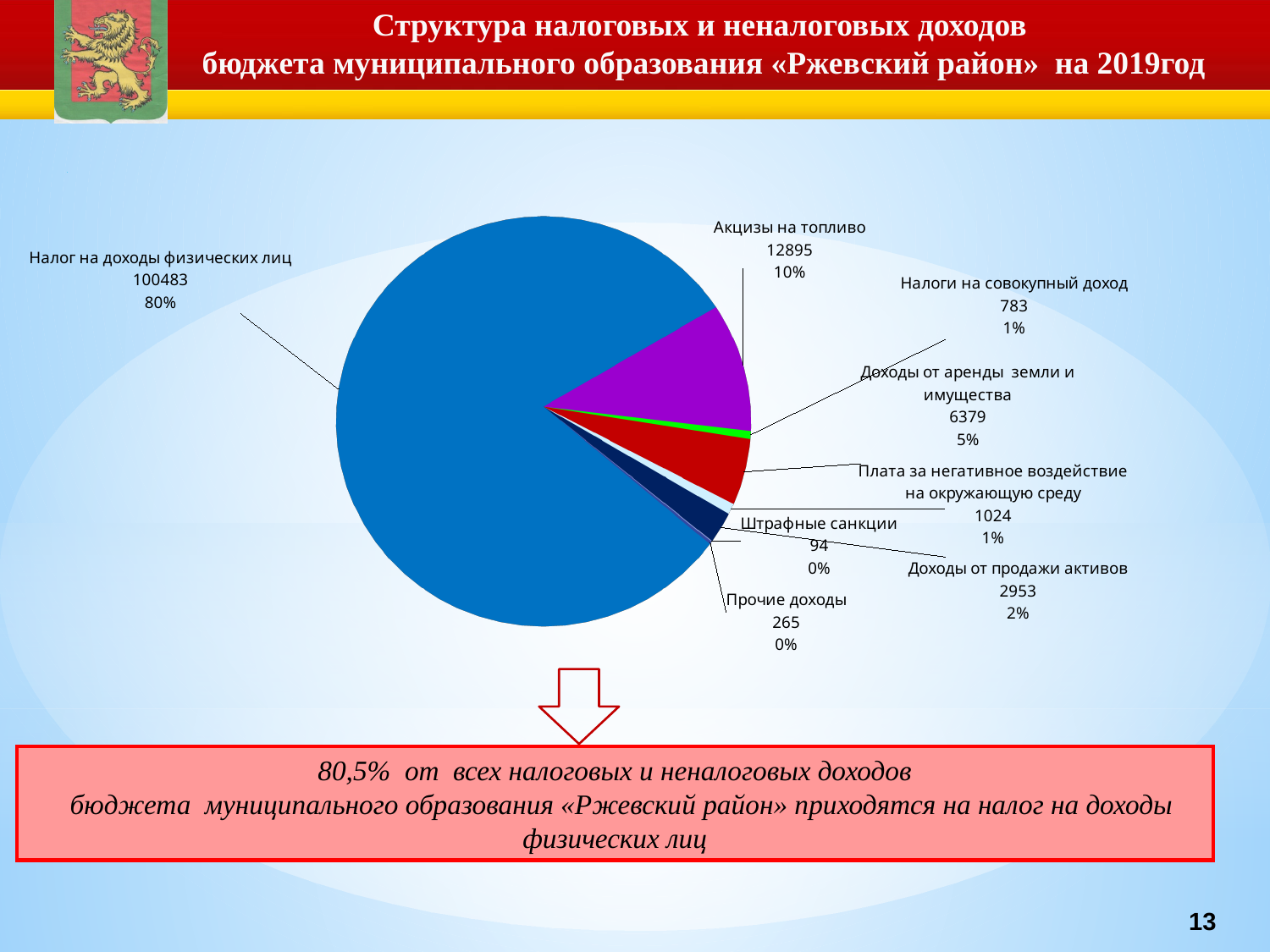
What is the value for Штрафные санкции? 94 What is the value for Прочие доходы? 265 What share of the pie does Акцизы на топливо represent? 10% What is the value for Доходы от аренды земли и имущества? 6379 How many slices does the pie chart have? 8 What share of the pie does Доходы от продажи активов represent? 2% Which is larger: Налоги на совокупный доход or Плата за негативное воздействие на окружающую среду? Плата за негативное воздействие на окружающую среду What type of chart is shown on the slide? pie chart What is the difference between the values for Акцизы на топливо and Доходы от продажи активов? 9942 Which category has the largest slice of the pie? Налог на доходы физических лиц Which category has the smallest slice of the pie? Штрафные санкции What is the value for Налог на доходы физических лиц? 100483